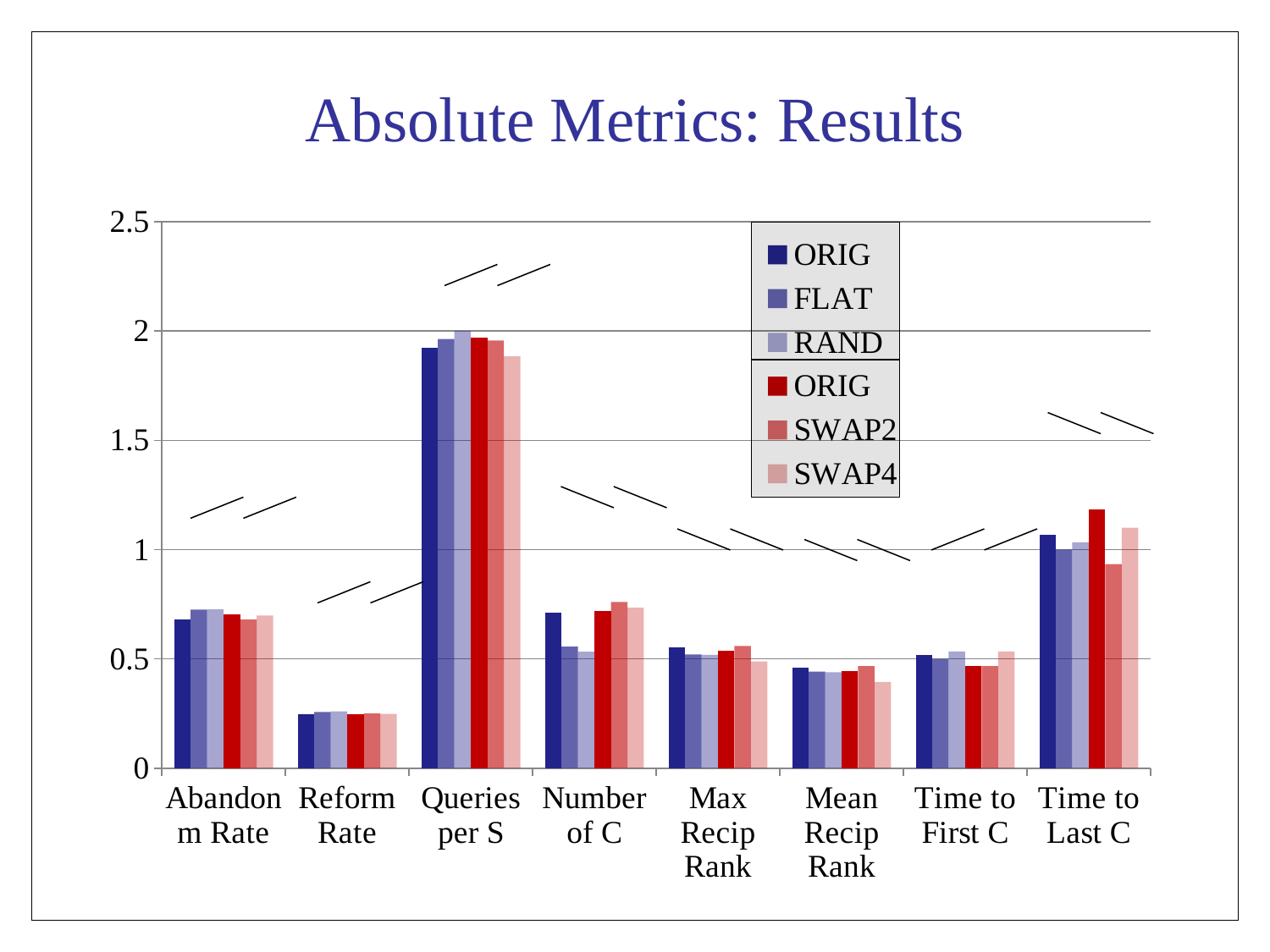
How many series does the legend list? 6 What is the title of the chart? Absolute Metrics: Results Is the value for RAND in Queries per S greater or less than 1.5? greater What kind of chart is shown on the slide? bar chart Is the value for FLAT in Reform Rate greater or less than 0.5? less In Number of C, which is larger: SWAP2 or FLAT? SWAP2 How many categories are shown on the x axis? 8 Is the value for SWAP4 in Mean Recip Rank greater or less than 0.5? less Which category has the lowest bars? Reform Rate Which category has the highest bars? Queries per S In Time to Last C, which is larger: the red ORIG bar or the SWAP2 bar? ORIG